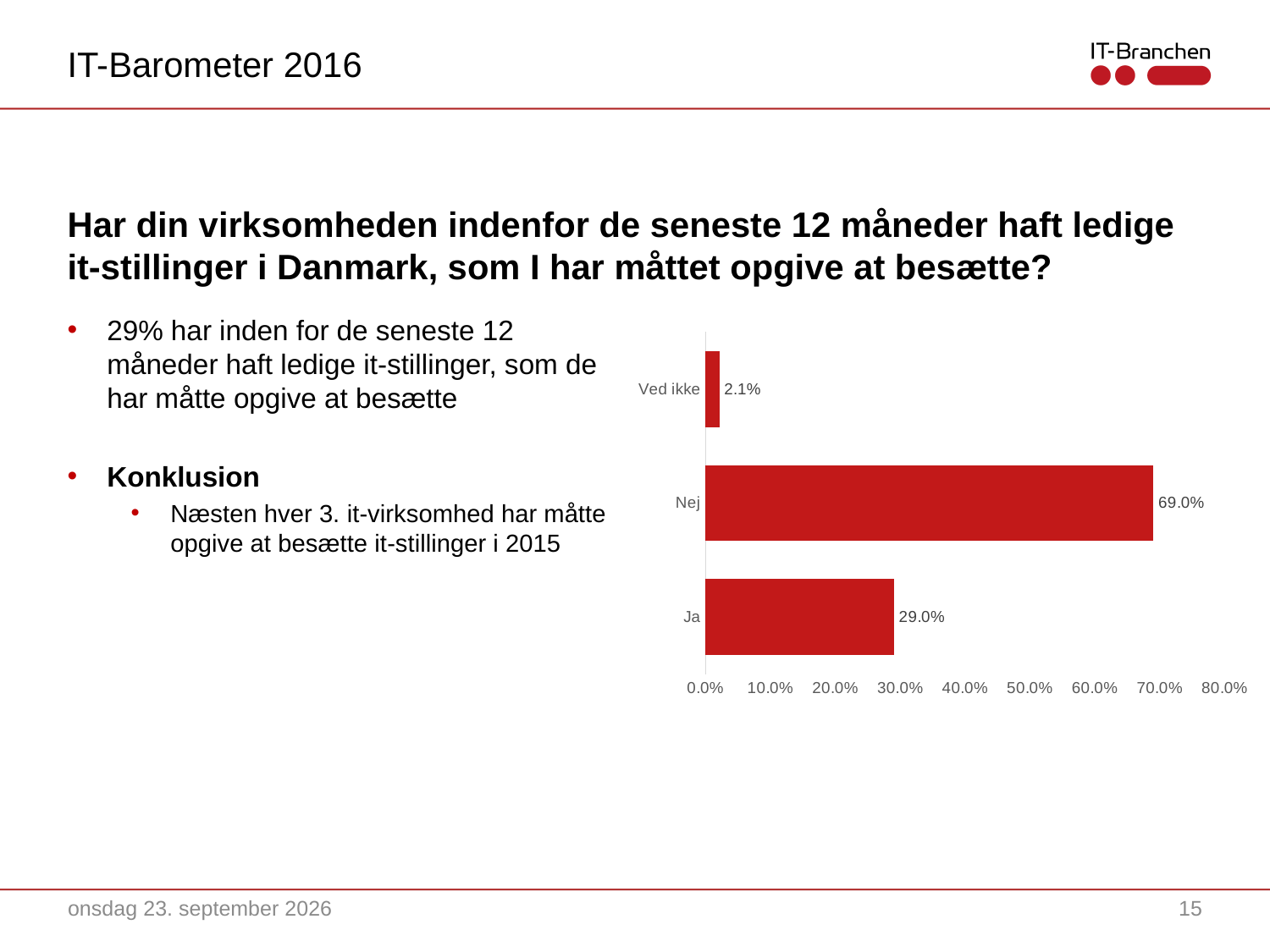
Which category has the highest value? Nej What is the value for Nej? 69.0% What is the value for Ja? 29.0% What is the highest value shown on the x axis? 80.0% Which is larger, the value for Ja or the value for Ved ikke? Ja How many categories are shown in the chart? 3 What is the value for Ved ikke? 2.1% Which category has the lowest value? Ved ikke Is the value for Nej greater or less than 60.0%? greater Is the value for Ja greater or less than 40.0%? less What is the difference between the values for Nej and Ja? 40.0% What kind of chart is shown on the slide? bar chart